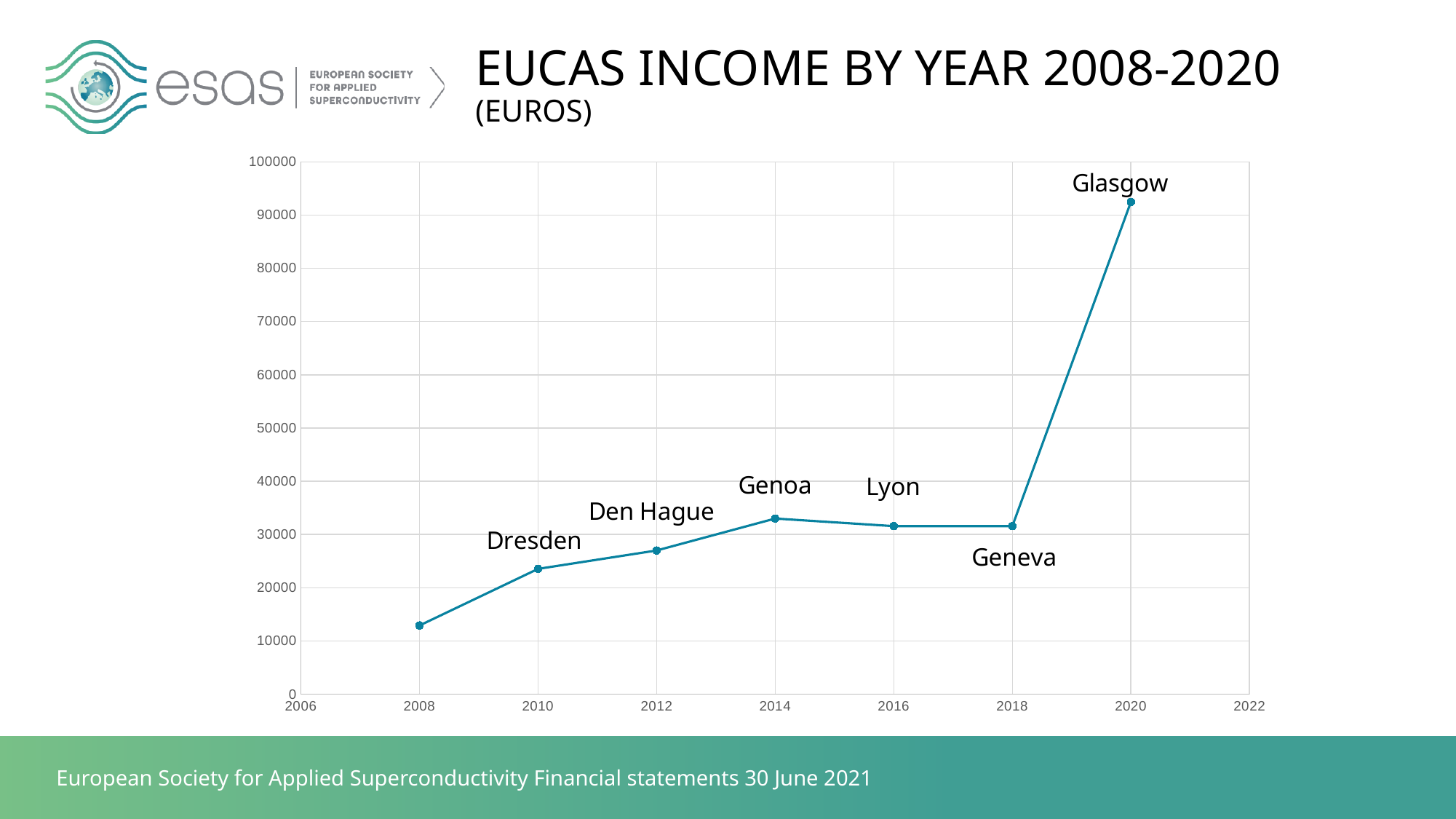
Which year has the lowest EUCAS income? 2008 Is the value for 2020 greater or less than 80000? greater Is the value for 2014 greater or less than 30000? greater Do the values rise or fall from 2008 to 2014? rise Which year has the larger income, 2010 or 2012? 2012 How many data points are plotted on the line? 7 Is the value for 2008 greater or less than 20000? less Which year has the highest EUCAS income? 2020 Which year has the larger income, 2018 or 2020? 2020 What kind of chart is shown on the slide? line chart Which city label is attached to the 2020 data point? Glasgow